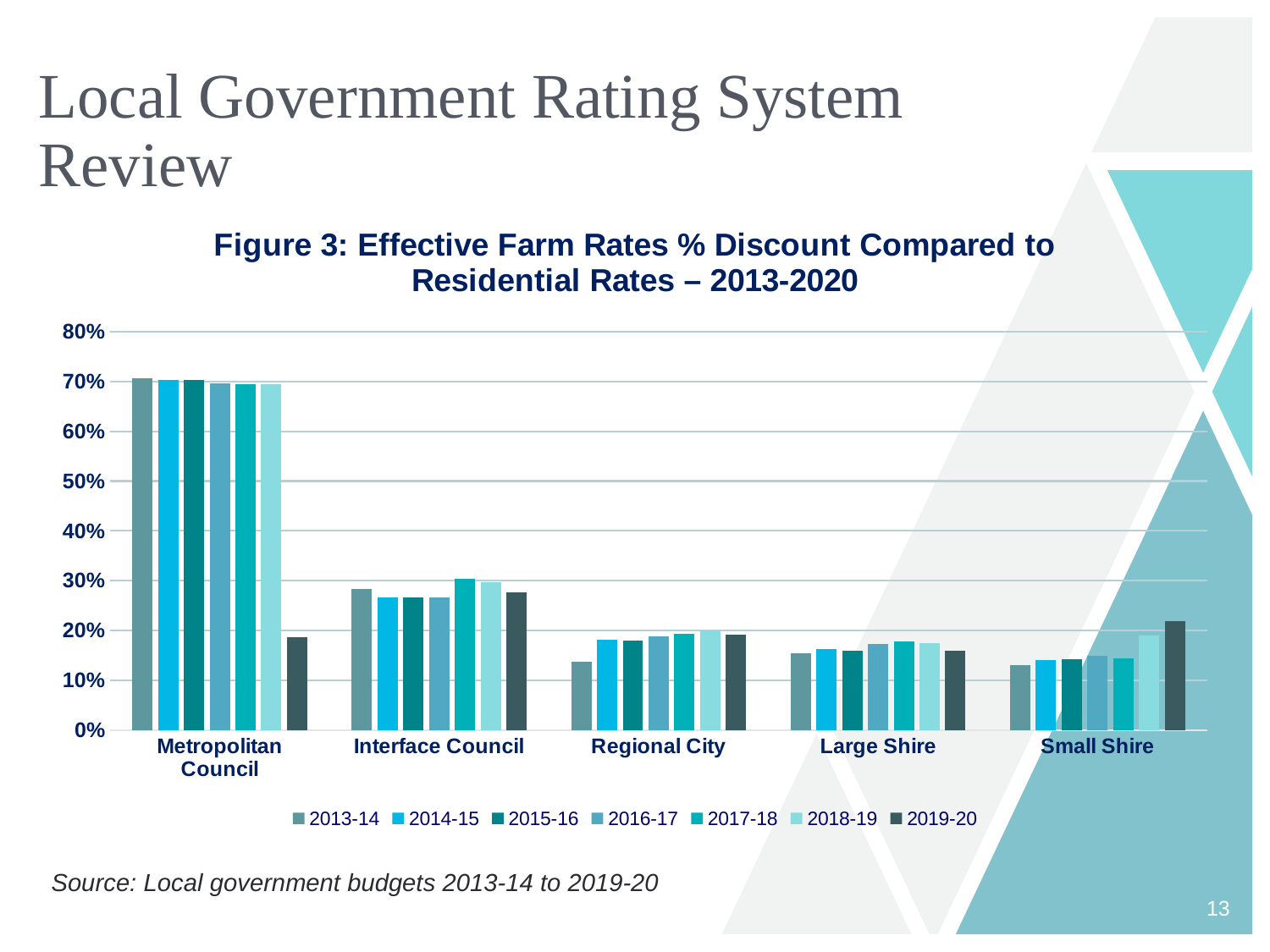
What kind of chart is shown in Figure 3? Bar chart Is the value for Metropolitan Council in 2013-14 greater or less than 60%? greater What is the title of the chart? Figure 3: Effective Farm Rates % Discount Compared to Residential Rates – 2013-2020 How many series does the legend list? 7 For Metropolitan Council, which year has the lowest value? 2019-20 How many council categories are shown on the x axis? 5 Is the value for Regional City in 2013-14 greater or less than 20%? less Which council category has the highest value in 2013-14? Metropolitan Council Which is larger, the 2013-14 value for Metropolitan Council or the 2013-14 value for Small Shire? Metropolitan Council Is the value for Interface Council in 2017-18 greater or less than 20%? greater Do the values for Metropolitan Council rise or fall from 2013-14 to 2019-20? fall